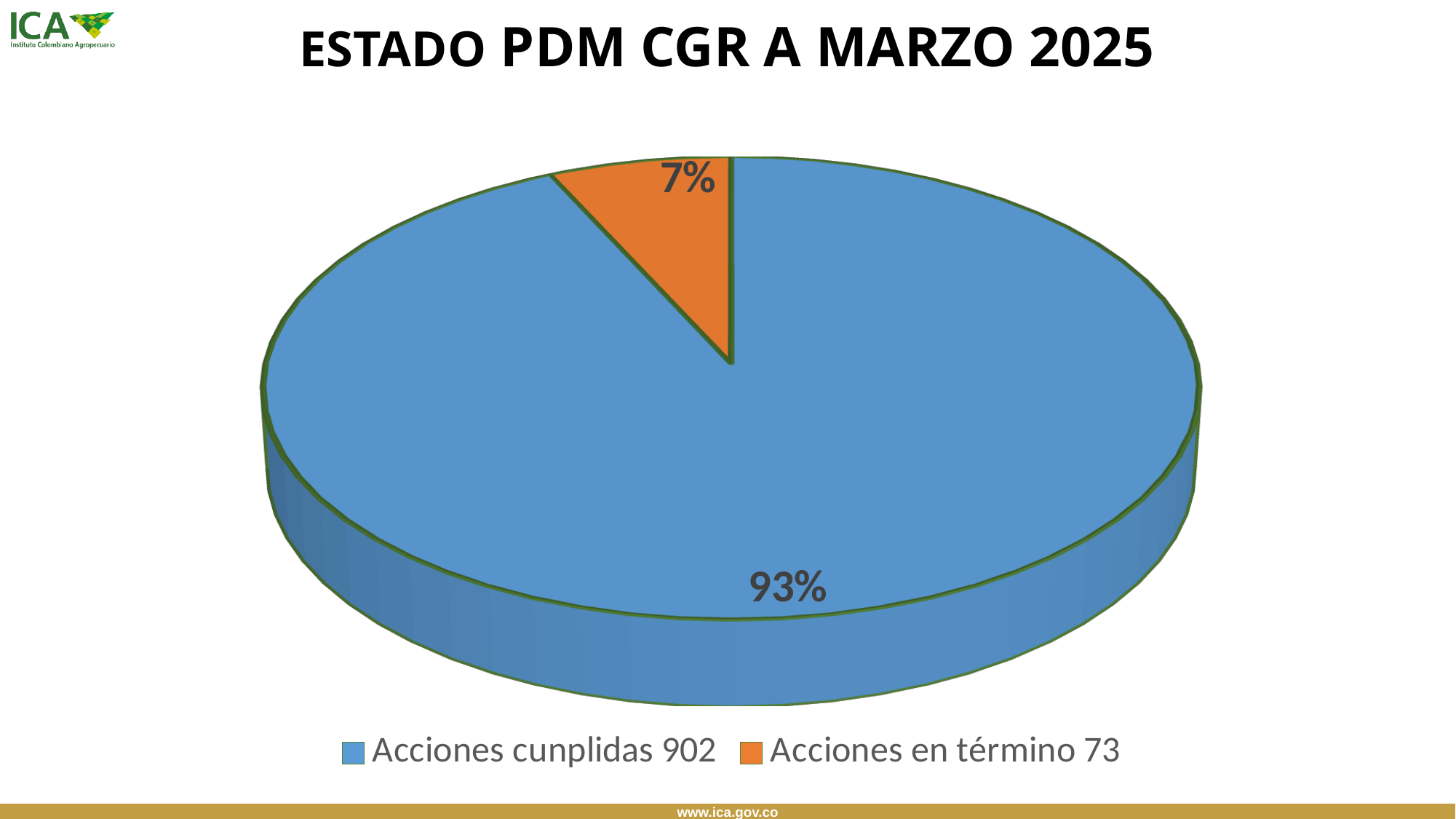
What percentage share does the 'Acciones cunplidas 902' slice have? 93% Which is larger, the share for 'Acciones cunplidas 902' or the share for 'Acciones en término 73'? Acciones cunplidas 902 What is the difference in percentage points between the 93% slice and the 7% slice? 86 What is the title of the chart on the slide? ESTADO PDM CGR A MARZO 2025 Which slice is the smallest in the pie chart? Acciones en término 73 What colour is the 'Acciones en término 73' slice? orange Which slice is the largest in the pie chart? Acciones cunplidas 902 What kind of chart is shown on the slide? pie chart How many entries does the legend list? 2 What percentage share does the 'Acciones en término 73' slice have? 7% How many slices does the pie chart have? 2